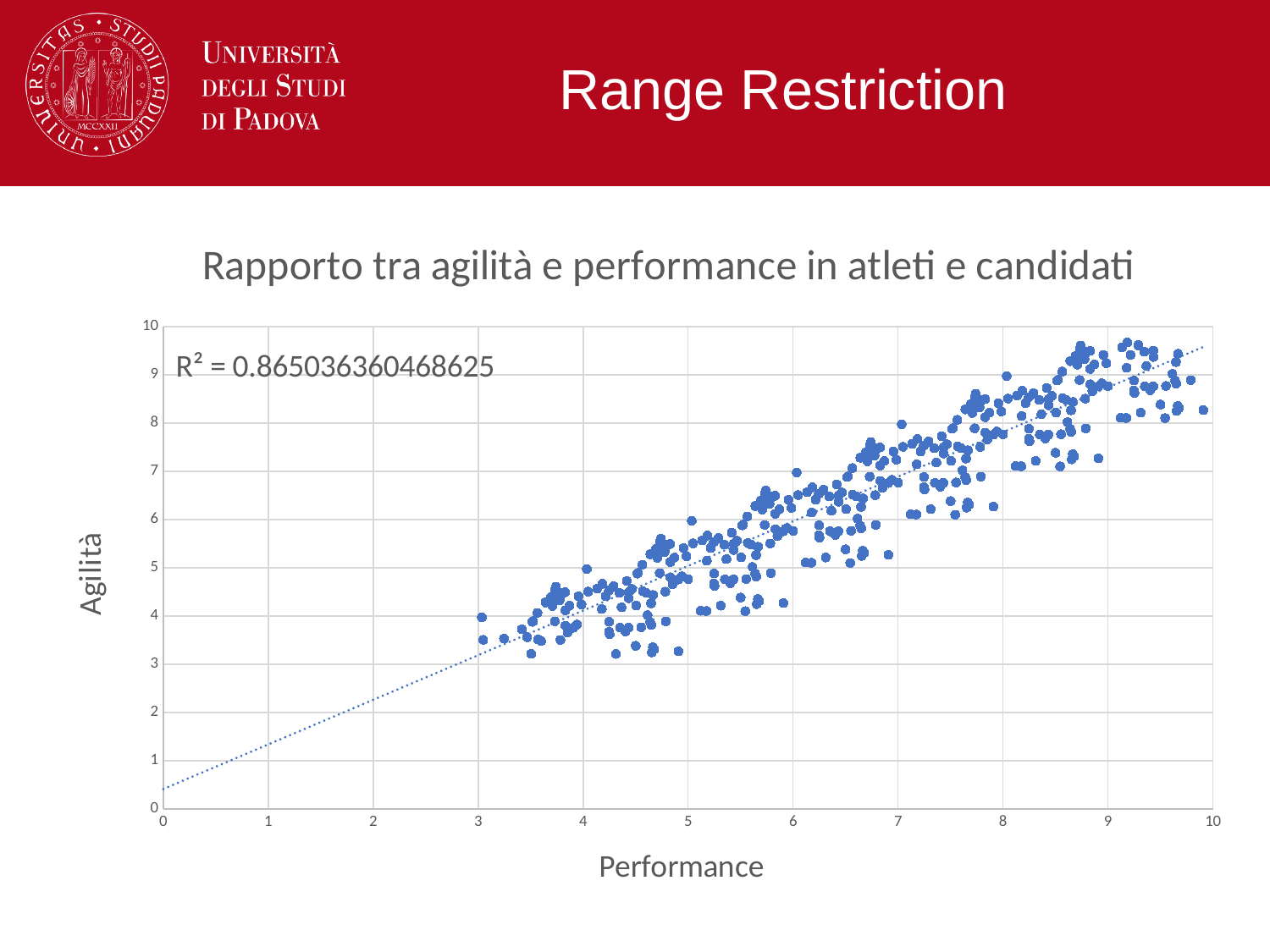
What is the label of the x axis? Performance What is the R² value printed on the chart? R² = 0.865036360468625 Are the plotted points' Agilità values greater or less than 3? greater Is the R² value greater or less than 0.8? greater What is the maximum value shown on the y axis (Agilità)? 10 What is the maximum value shown on the x axis (Performance)? 10 What kind of chart is shown on the slide? Scatter plot What is the title of the chart? Rapporto tra agilità e performance in atleti e candidati Is the trendline on the chart drawn as a solid or dotted line? Dotted Does Agilità rise or fall as Performance increases along the x axis? Rise